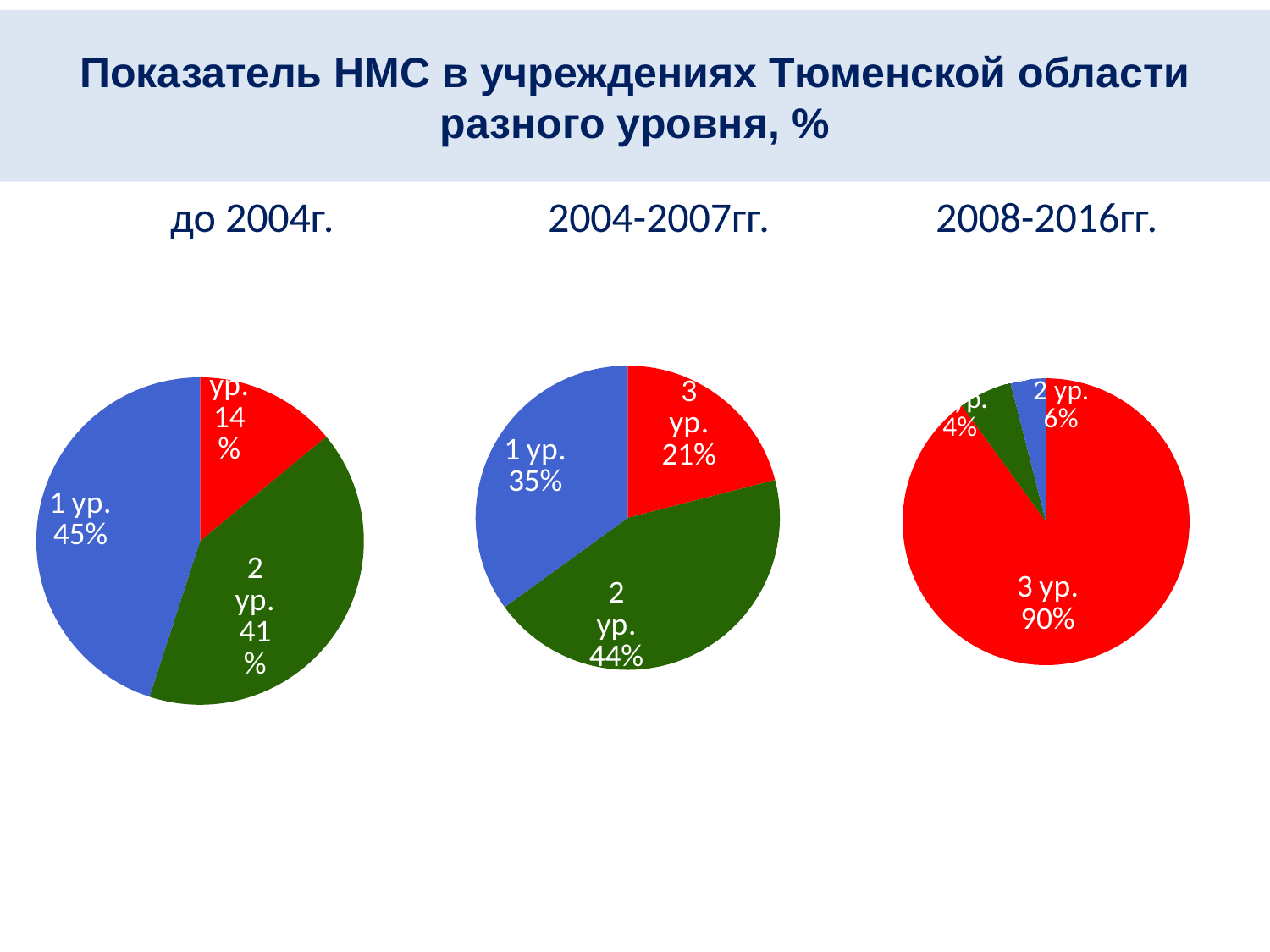
What type of chart is used for the 'до 2004г.' data? Pie chart In the '2004-2007гг.' pie chart, what is the difference between the shares of 2 ур. and 1 ур.? 9% In the 'до 2004г.' pie chart, what share is labelled for 1 ур.? 45% In the 'до 2004г.' pie chart, what percentage is shown on the red slice? 14% In the '2004-2007гг.' pie chart, what share is labelled for 3 ур.? 21% In the '2008-2016гг.' pie chart, what share is labelled for 2 ур.? 6% In the '2004-2007гг.' pie chart, which is larger: the share of 1 ур. or the share of 3 ур.? 1 ур. In the '2008-2016гг.' pie chart, which category has the smallest slice? 1 ур. How many pie charts are shown on the slide? 3 In the '2004-2007гг.' pie chart, which category has the largest slice? 2 ур. In the 'до 2004г.' pie chart, what share is labelled for 2 ур.? 41% In the '2008-2016гг.' pie chart, what share is labelled for 3 ур.? 90%